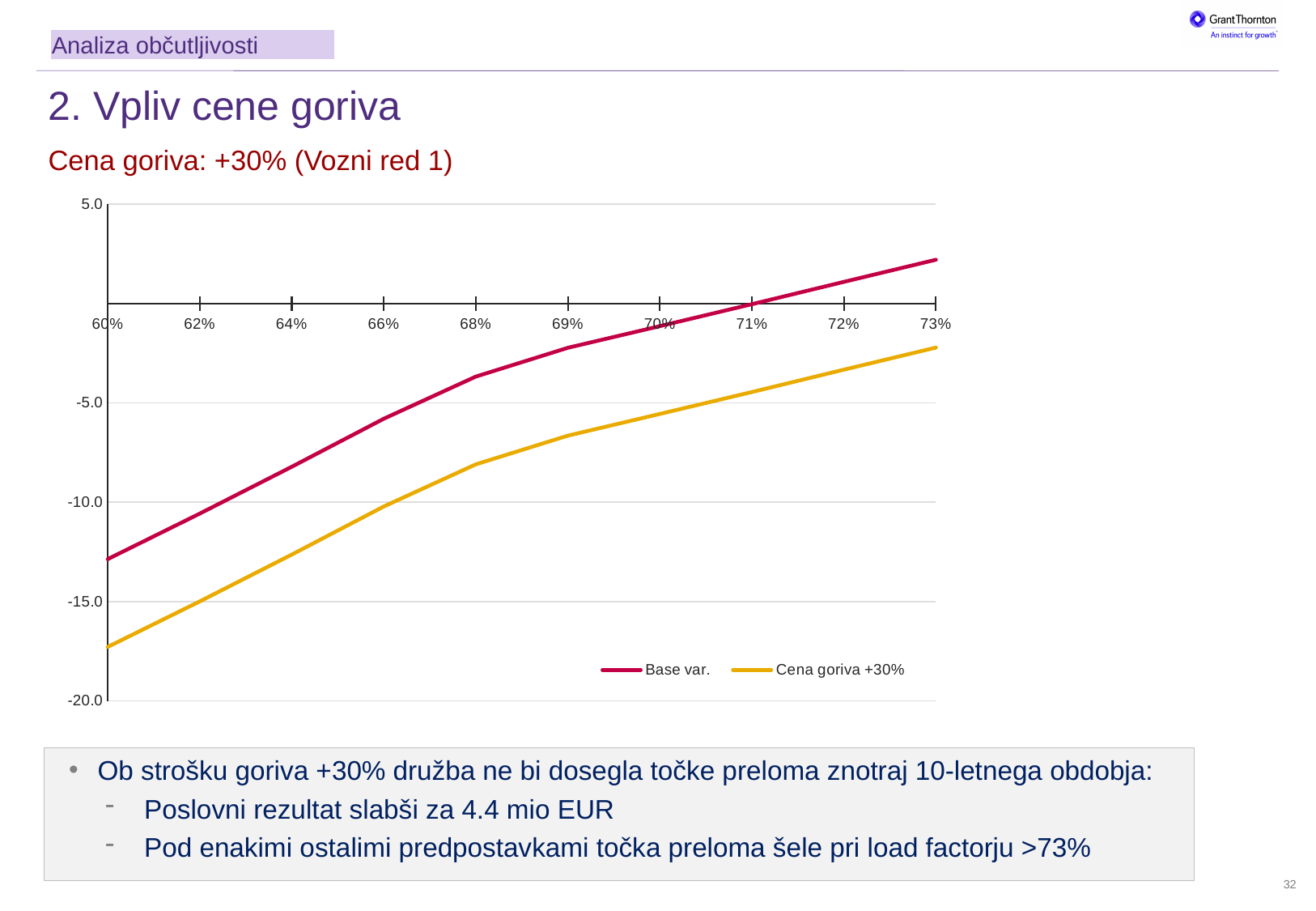
What are the two series named in the legend? Base var. and Cena goriva +30% What kind of chart is shown on the slide? line chart How many series does the legend list? 2 Is the value of the Cena goriva +30% series at 68% greater or less than -5.0? less At which load factor on the x axis does the Cena goriva +30% series reach its lowest value? 60% Is the value of the Cena goriva +30% series at 60% greater or less than -15.0? less At a load factor of 73%, which series has the higher value, Base var. or Cena goriva +30%? Base var. Do the values of the Base var. series rise or fall as the load factor increases along the x axis? rise Is the value of the Base var. series at 73% greater or less than 0? greater How many load factor values are marked on the x axis? 10